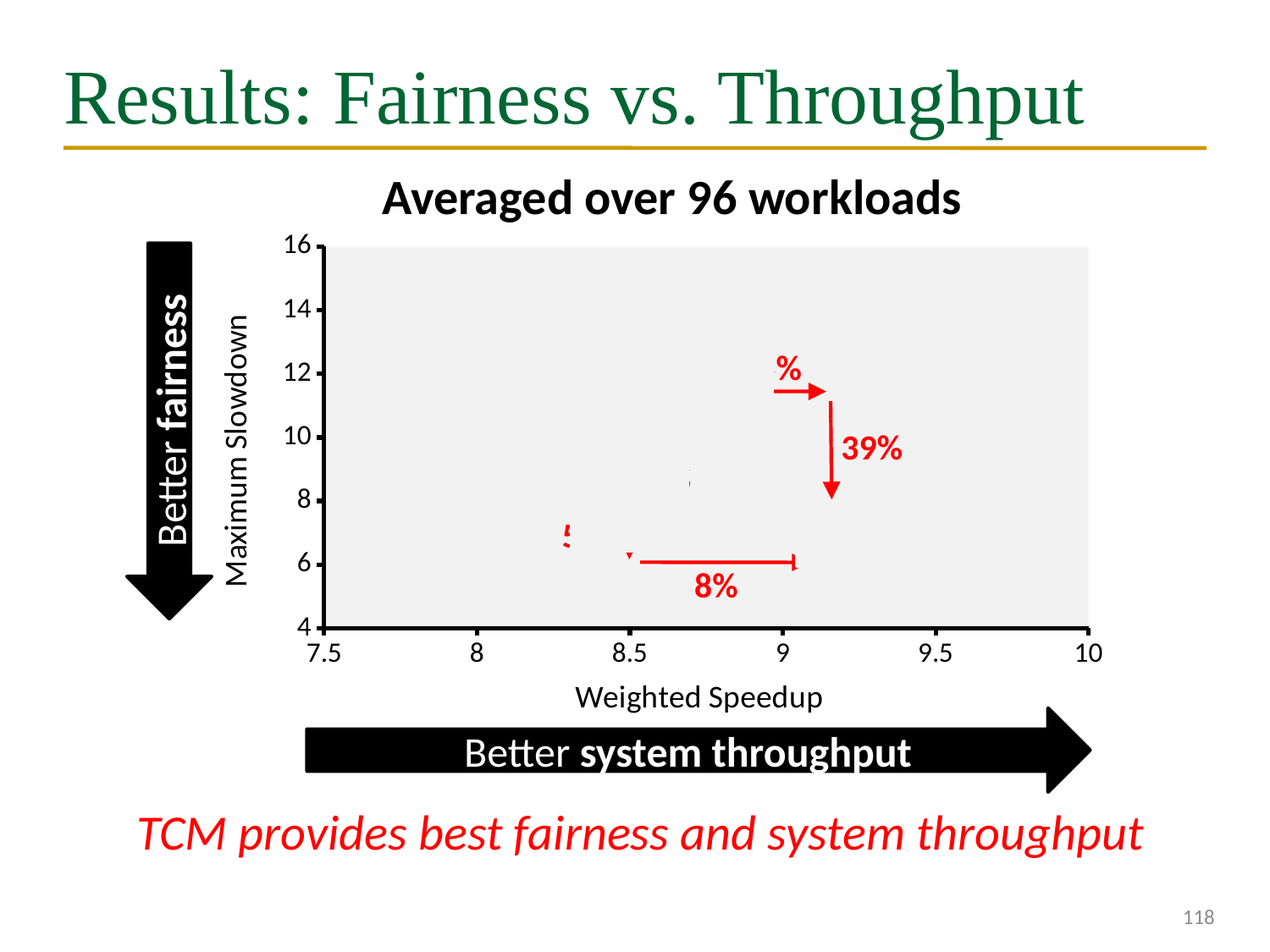
What is the title of the chart? Averaged over 96 workloads What percentage is printed below the horizontal red arrow near the bottom of the chart? 8% What percentage is printed next to the downward-pointing red arrow on the chart? 39% What kind of chart is shown on the slide? scatter chart What is the label of the vertical axis of the chart? Maximum Slowdown